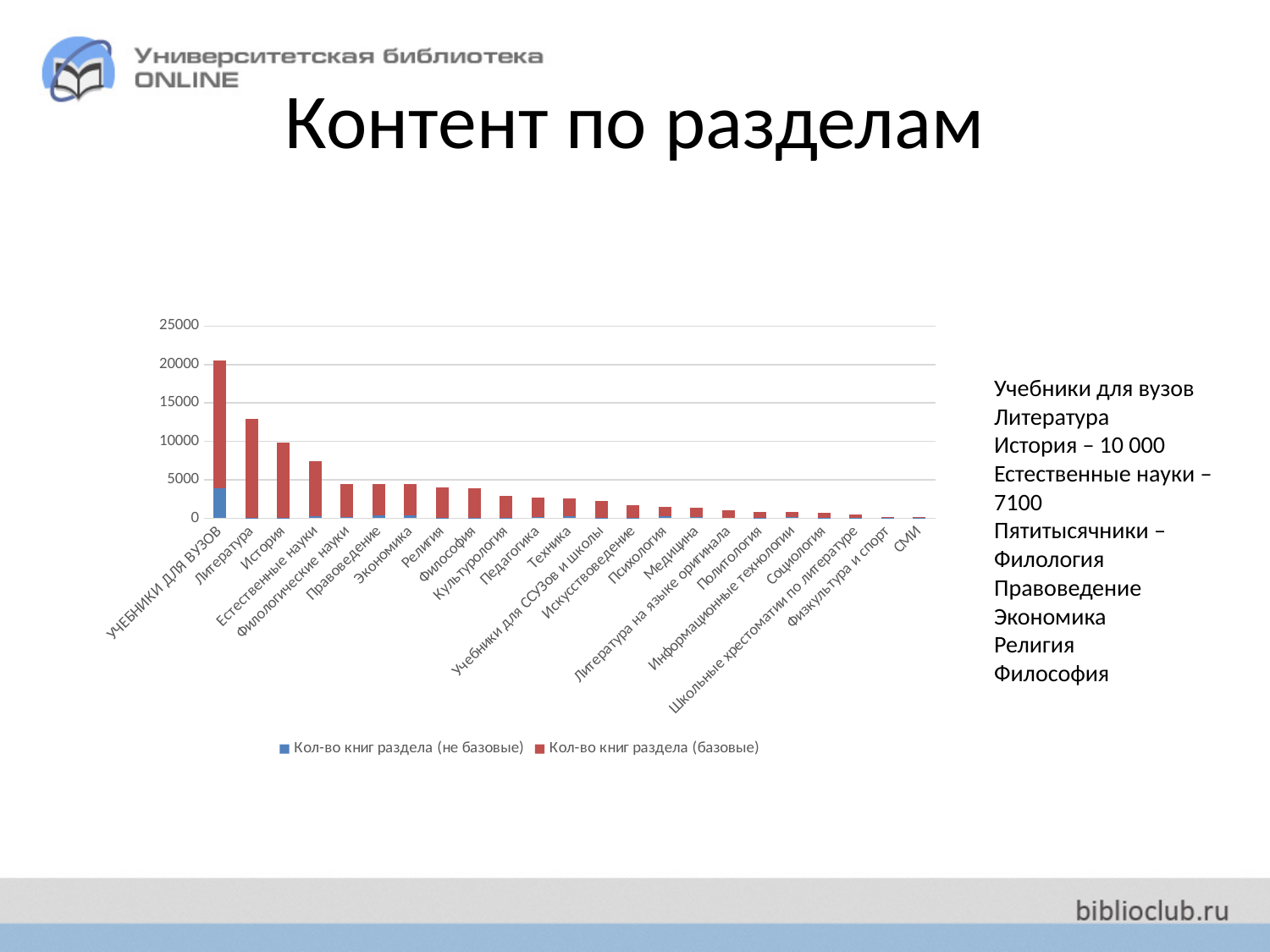
Is the value for Литература greater or less than 10000? greater Which category has the highest total bar? Учебники для вузов Do the bar values rise or fall moving from left to right along the x axis? fall How many series does the legend list? 2 How many categories are plotted along the x axis? 23 What kind of chart is shown on the slide? bar chart Is the value for Естественные науки greater or less than 5000? greater Which is larger, the bar for Естественные науки or the bar for Экономика? Естественные науки Is the value for Правоведение greater or less than 5000? less What is the title of the slide containing the chart? Контент по разделам Which is larger, the bar for Литература or the bar for История? Литература